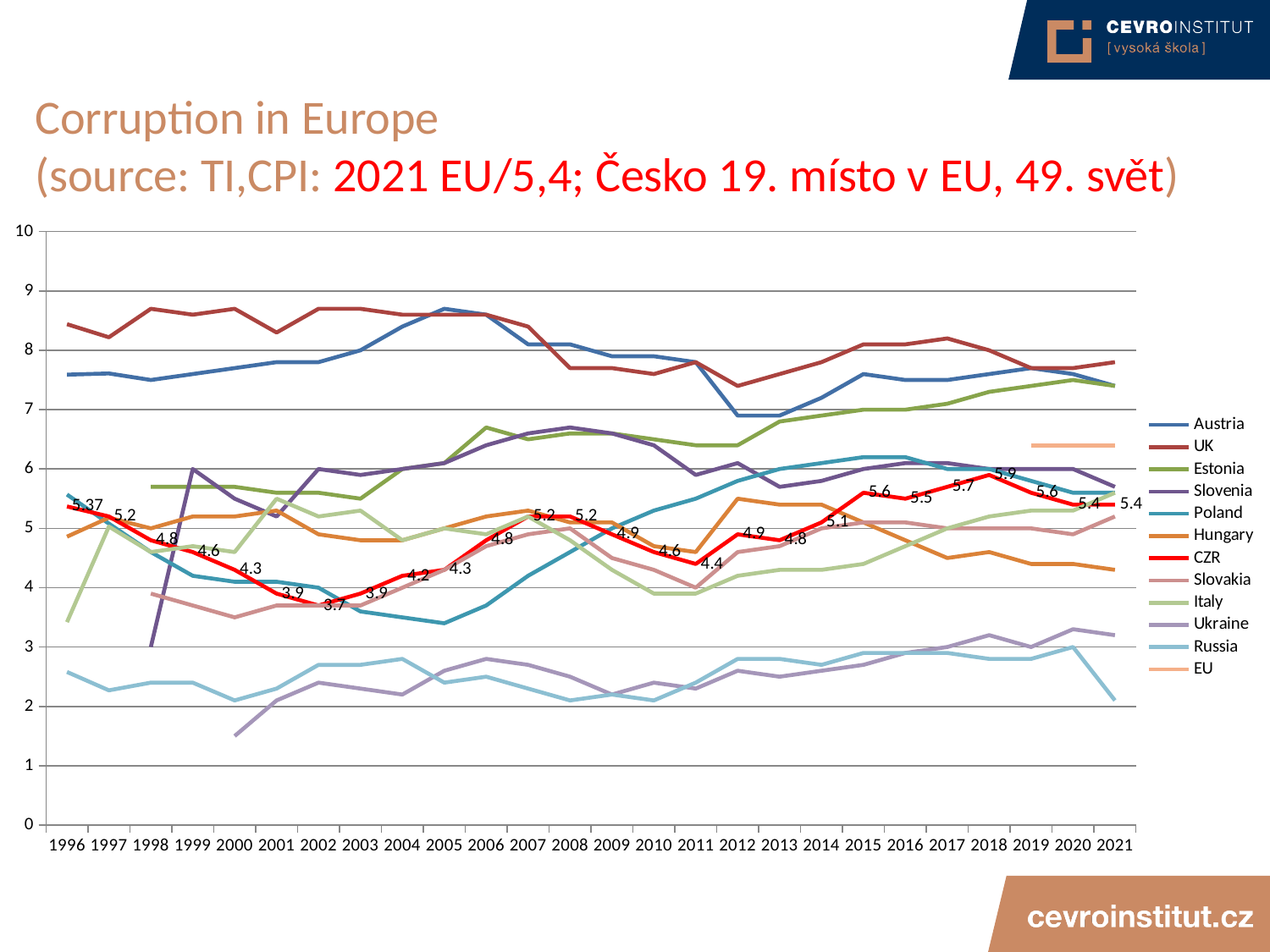
In which year is the CZR value highest? 2018 What is the CZR value for 2021? 5.4 How many series does the legend list? 12 What is the CZR value for 2018? 5.9 Is the value for Russia in 2021 greater or less than 3? less Which series has the higher value in 2012, UK or Austria? UK What is the difference between the CZR values for 2018 and 2002? 2.2 Does the CZR series rise or fall from 2011 to 2018? rise What kind of chart is shown on the slide? line chart What is the CZR value for 2002? 3.7 How many years are shown along the x axis? 26 In which year is the CZR value lowest? 2002